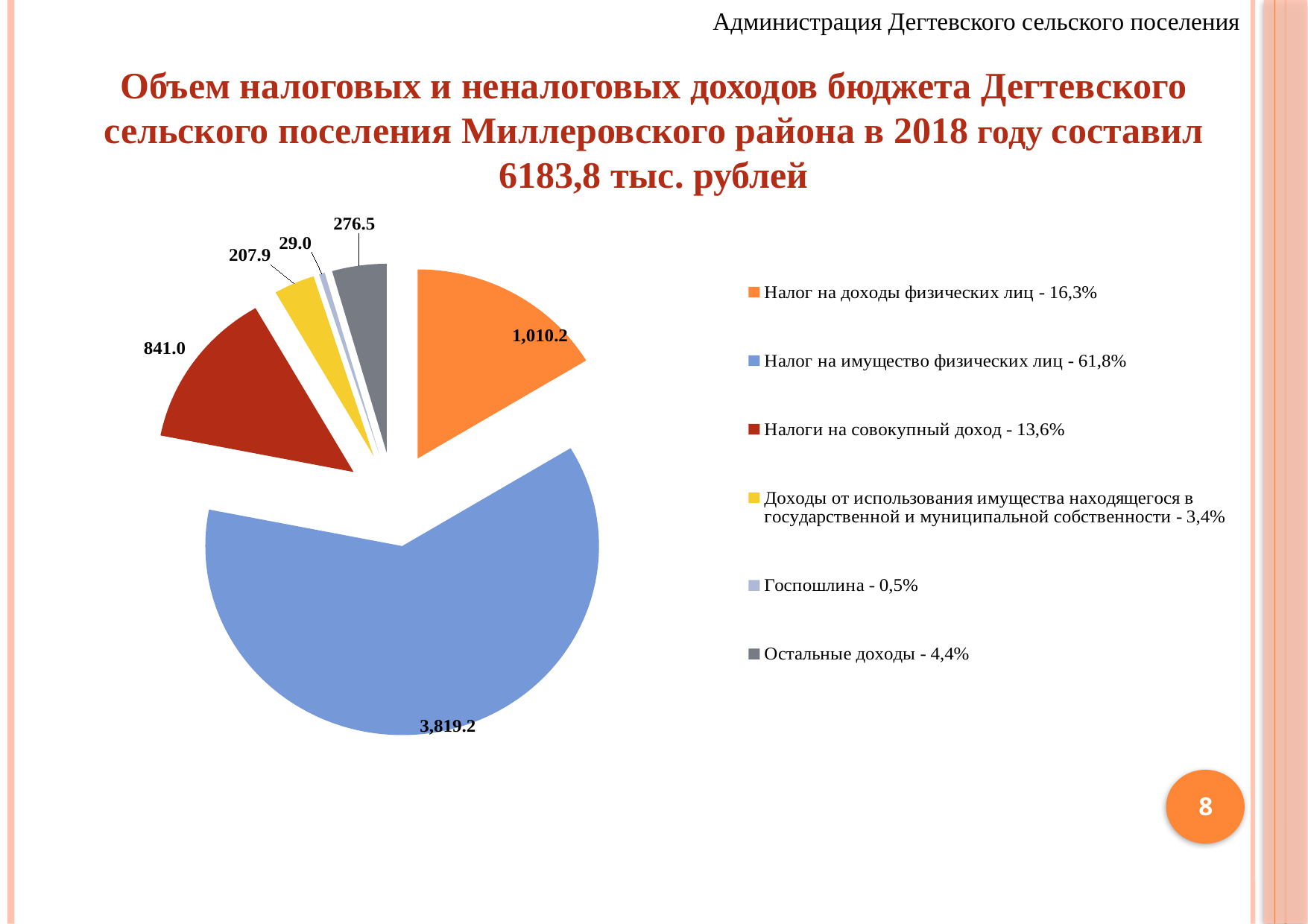
What share of the pie does Налоги на совокупный доход represent, according to the legend? 13,6% How many slices does the pie chart have? 6 What is the difference between the values for Налог на доходы физических лиц and Налоги на совокупный доход? 169.2 What is the value shown for Налог на доходы физических лиц? 1,010.2 Which category has the smallest slice of the pie? Госпошлина What is the value shown for Остальные доходы? 276.5 What type of chart is shown on the slide? pie chart Which is larger: the value for Остальные доходы or the value for Доходы от использования имущества находящегося в государственной и муниципальной собственности? Остальные доходы What is the value shown for Налог на имущество физических лиц? 3,819.2 What is the value shown for Госпошлина? 29.0 What share of the pie does Доходы от использования имущества находящегося в государственной и муниципальной собственности represent, according to the legend? 3,4% Which category has the largest slice of the pie? Налог на имущество физических лиц